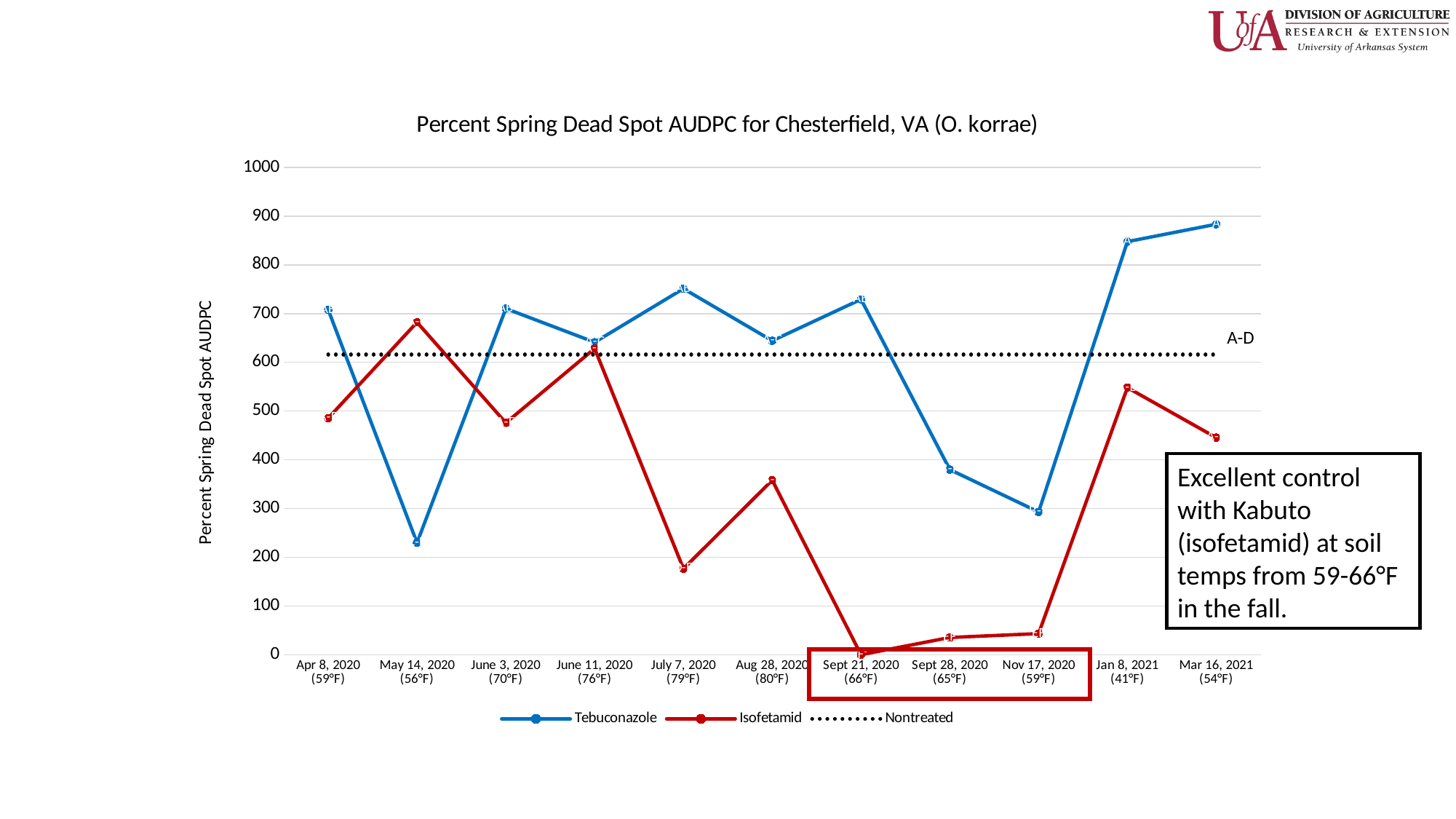
Is the Isofetamid value for Jan 8, 2021 greater or less than 500? greater How many dates are plotted along the x axis? 11 On which date does the Tebuconazole series reach its highest value? Mar 16, 2021 Is the Tebuconazole value for Mar 16, 2021 greater or less than 800? greater Does the Isofetamid series rise or fall between June 11, 2020 and July 7, 2020? Fall On which date does the Isofetamid series reach its lowest value? Sept 21, 2020 On which date does the Tebuconazole series reach its lowest value? May 14, 2020 What kind of chart is shown on the slide? Line chart Is the Tebuconazole value for May 14, 2020 greater or less than 300? less On Apr 8, 2020, which series has the larger value, Tebuconazole or Isofetamid? Tebuconazole How many series does the legend list? 3 Which series is drawn as a dotted line? Nontreated